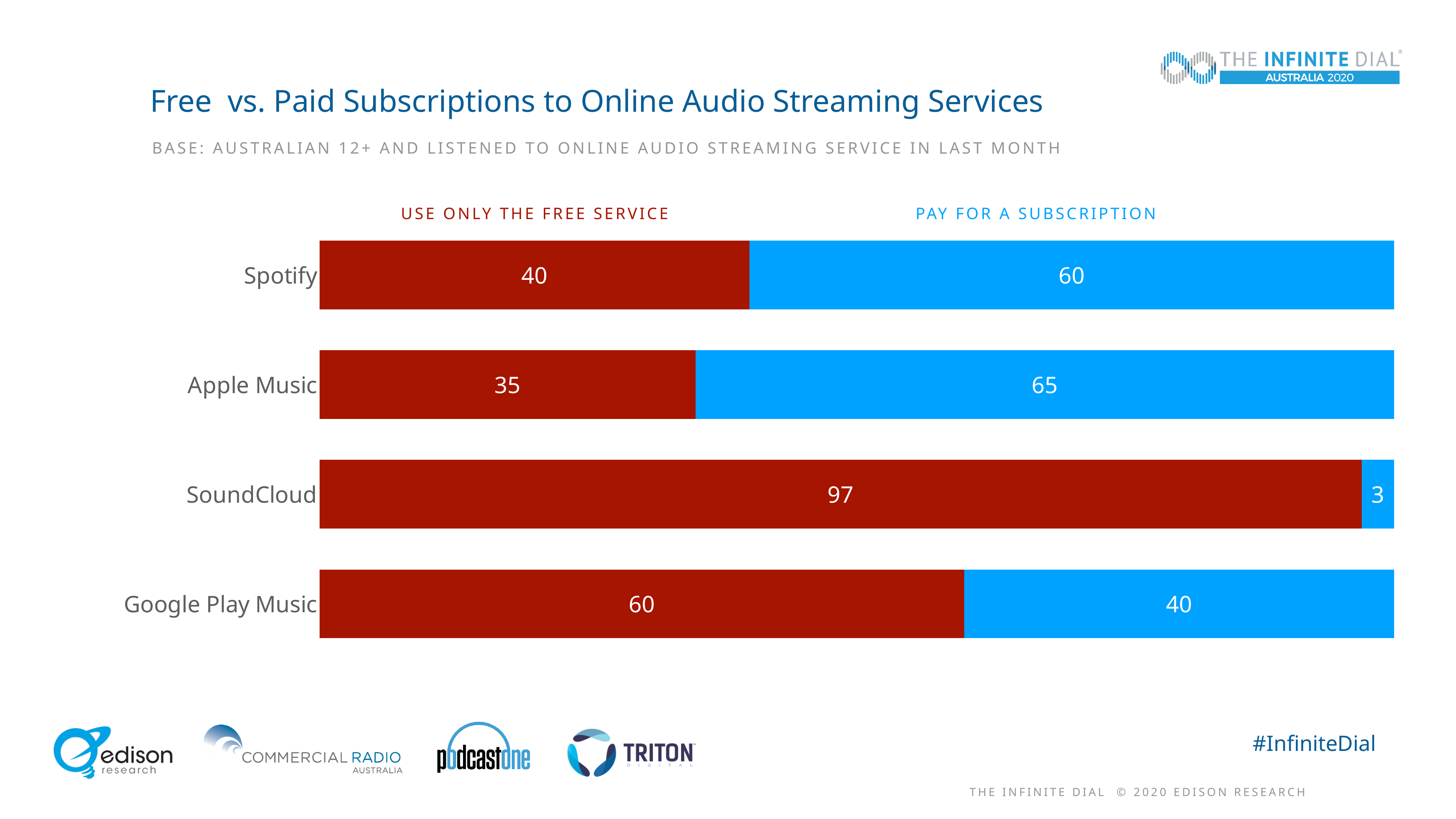
How many services are shown in the chart? 4 How many series does the chart show? 2 What colour represents the 'Pay for a subscription' series? Blue What is the 'Pay for a subscription' value for SoundCloud? 3 What kind of chart is shown on the slide? Stacked bar chart What is the total of the stacked bar for Apple Music? 100 What is the value for Apple Music in the 'Pay for a subscription' series? 65 Which service has the lowest 'Pay for a subscription' value? SoundCloud What percentage of Spotify listeners use only the free service? 40 What is the difference between the 'Use only the free service' values for Google Play Music and Spotify? 20 Which service has the highest 'Use only the free service' value? SoundCloud Which is larger: the 'Pay for a subscription' value for Spotify or for Google Play Music? Spotify